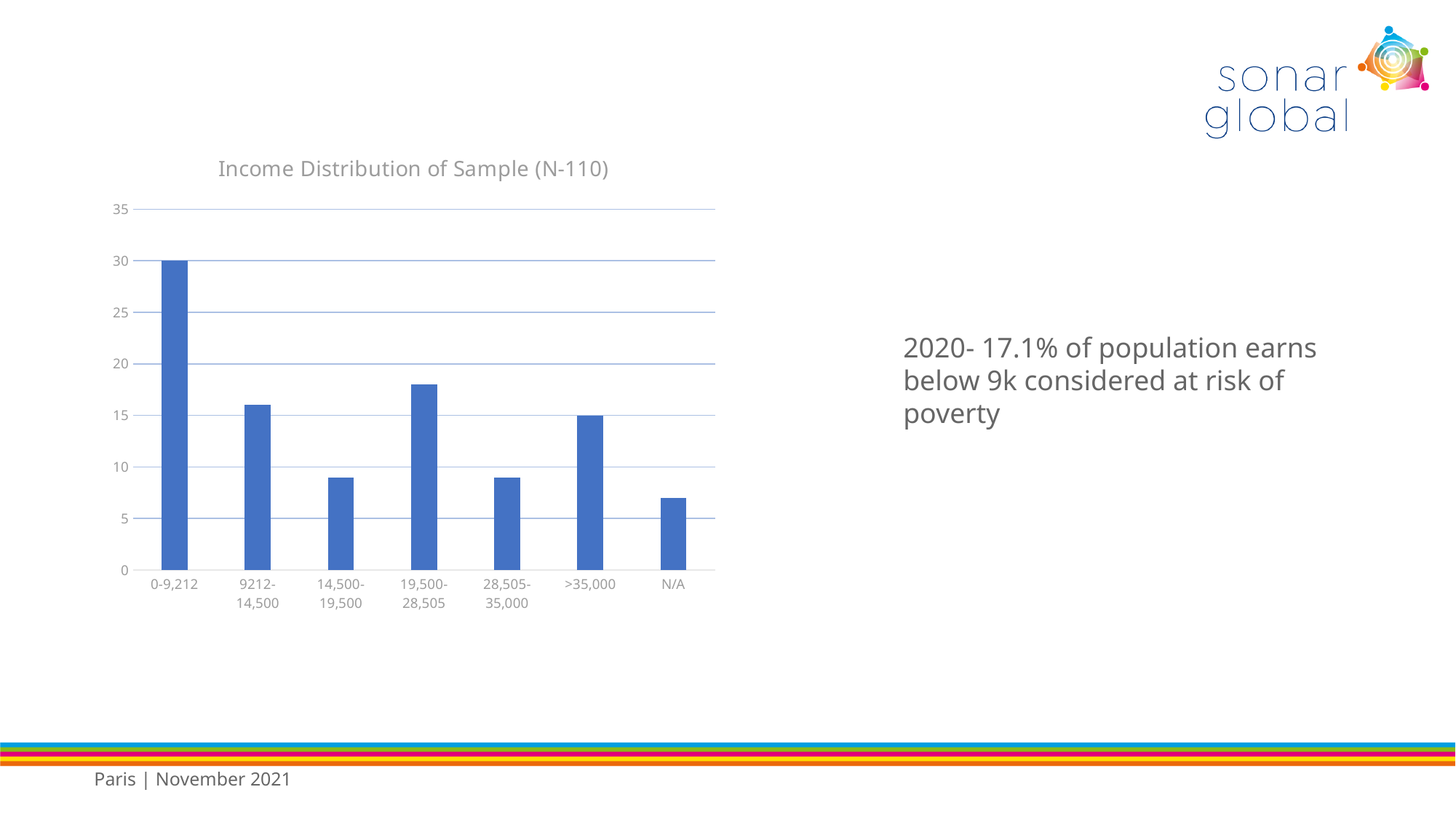
Is the value for 14,500-19,500 greater or less than 10? less What is the value for the >35,000 income category? 15 What is the title of the chart? Income Distribution of Sample (N-110) What is the difference between the values for 0-9,212 and >35,000? 15 What is the value for the 0-9,212 income category? 30 Is the value for 19,500-28,505 greater or less than 20? less Which income category has the highest value? 0-9,212 Which has a larger value, 19,500-28,505 or 28,505-35,000? 19,500-28,505 How many income categories are shown on the x axis of the chart? 7 Is the value for 9212-14,500 greater or less than 20? less Which category has the lowest value? N/A What type of chart is shown on the slide? bar chart